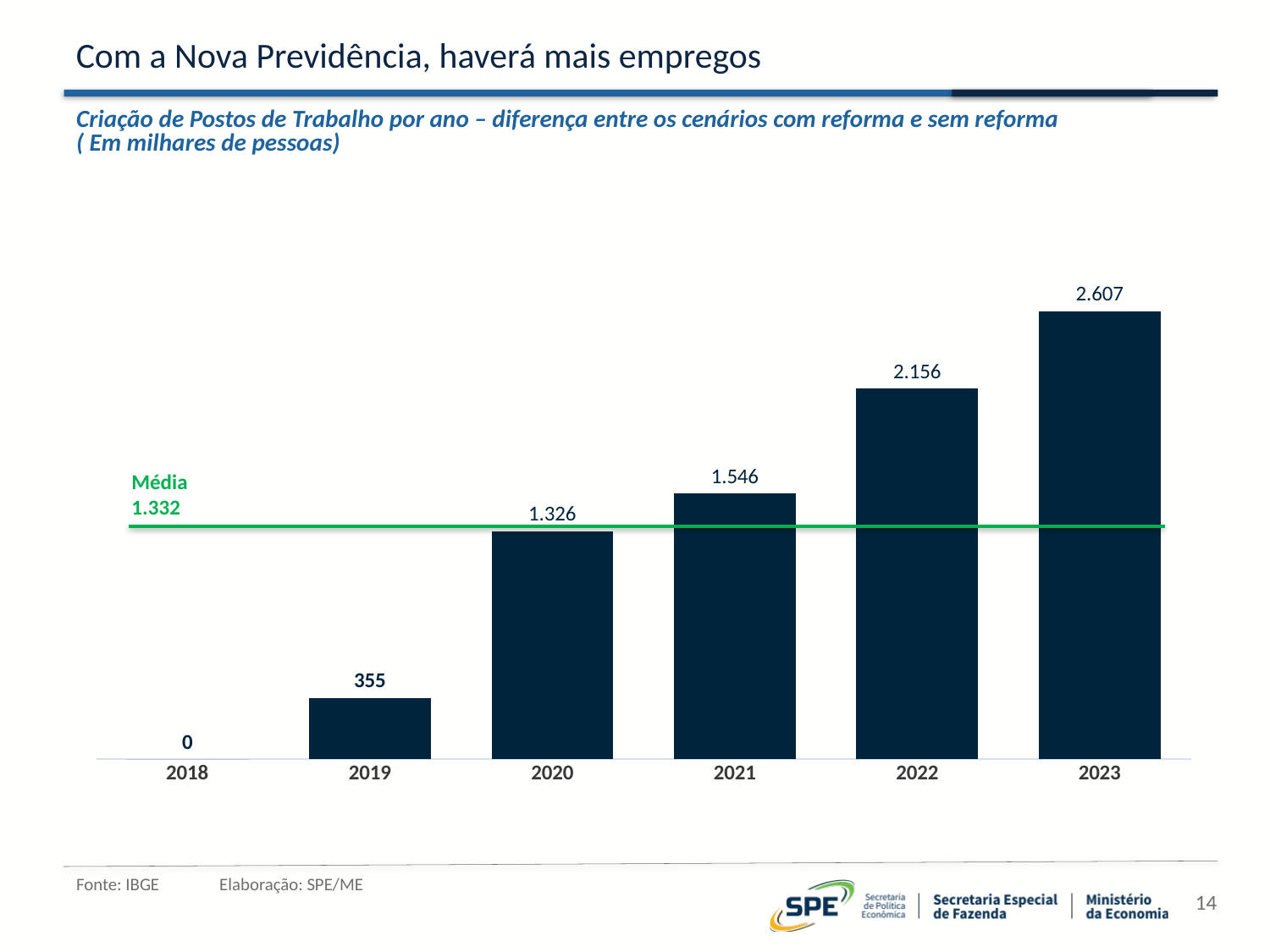
What is the difference between the values for 2021 and 2020? 220 Which year has the highest value? 2023 What is the difference between the values for 2023 and 2022? 451 What kind of chart is shown on the slide? Bar chart What value is labelled as the 'Média' (average) on the chart? 1.332 How many years are shown on the x axis? 6 What is the value for 2022? 2.156 Which is larger, the value for 2021 or the value for 2019? 2021 Do the values rise or fall from 2018 to 2023? Rise What is the value for 2019? 355 Which year has the lowest value? 2018 What is the value for 2020? 1.326